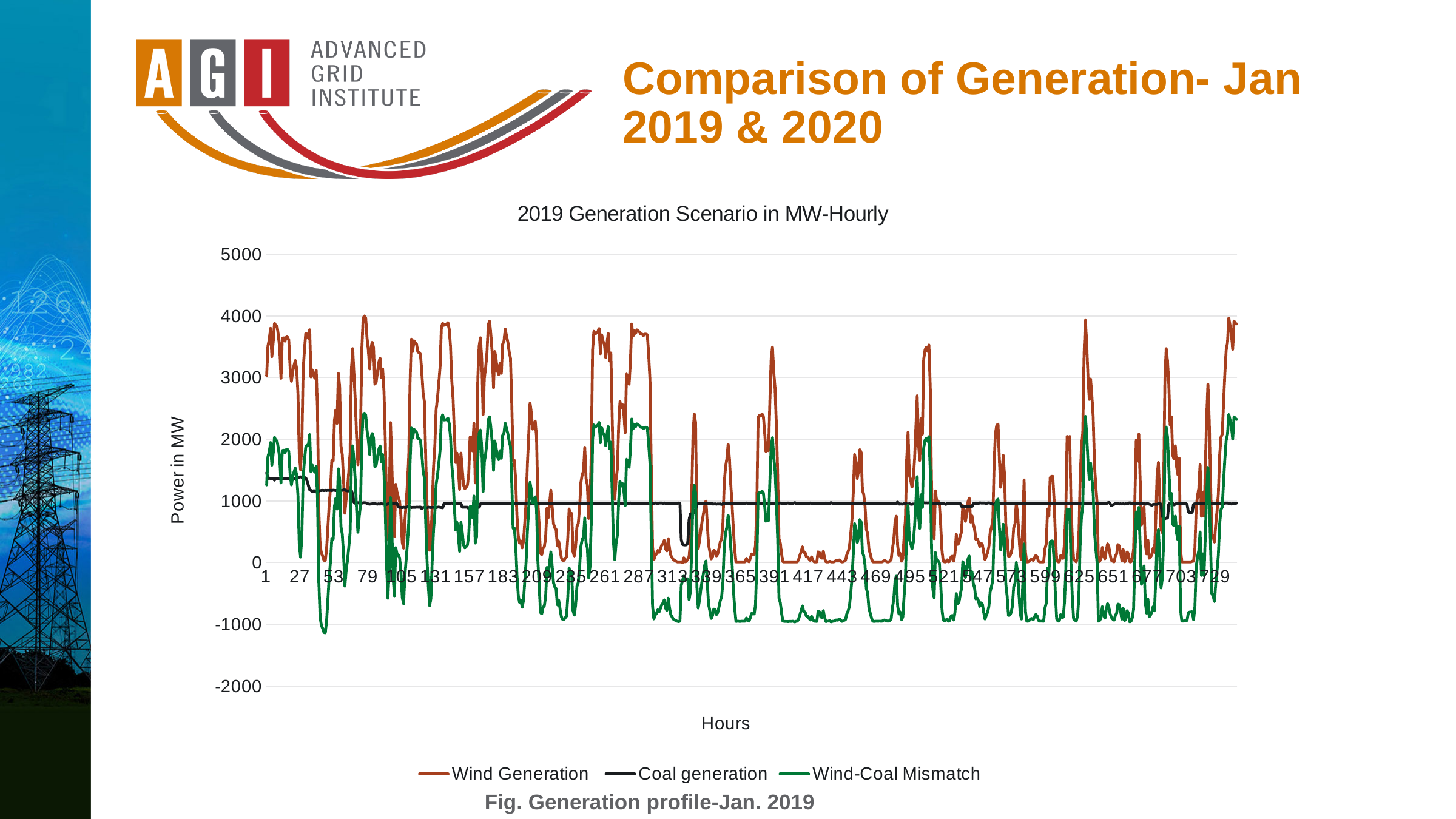
At hour 1, which is larger: Wind Generation or Coal generation? Wind Generation How many series does the legend list? 3 Is the value of Coal generation at hour 1 greater or less than 1000? greater Does Coal generation generally rise or fall from hour 1 to hour 105? fall Is the peak value of Wind Generation greater or less than 3000? greater Which series reaches the highest value on the chart? Wind Generation What is the label of the vertical axis? Power in MW What kind of chart is shown on the slide? line chart Which series is the only one that drops below 0? Wind-Coal Mismatch Is the value of Coal generation at hour 729 greater or less than 2000? less What is the title of the chart? 2019 Generation Scenario in MW-Hourly